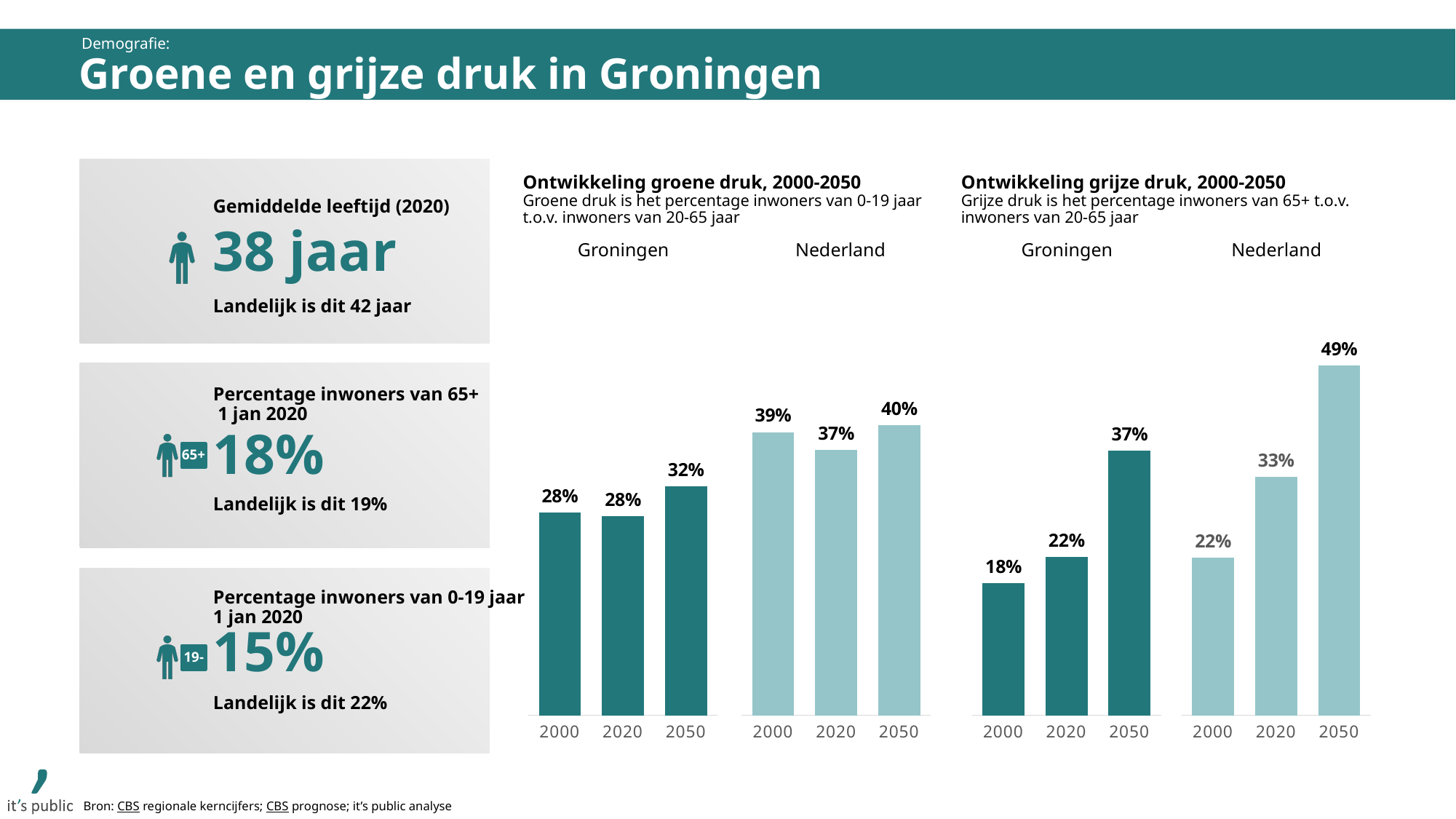
In the chart 'Ontwikkeling grijze druk, 2000-2050', what is the value for Nederland in 2050? 49% In the chart 'Ontwikkeling grijze druk, 2000-2050', which is larger: Groningen 2020 or Nederland 2020? Nederland 2020 In the chart 'Ontwikkeling grijze druk, 2000-2050', which bar has the highest value? Nederland 2050 In the chart 'Ontwikkeling grijze druk, 2000-2050', what is the difference between Nederland 2050 and Groningen 2050? 12% In the chart 'Ontwikkeling grijze druk, 2000-2050', what is the value for Groningen in 2000? 18% How many bars are shown in the chart 'Ontwikkeling groene druk, 2000-2050'? 6 In the chart 'Ontwikkeling groene druk, 2000-2050', which bar has the lowest value? Groningen 2000 and 2020 (28%) In the chart 'Ontwikkeling groene druk, 2000-2050', what is the value for Groningen in 2050? 32% In the chart 'Ontwikkeling groene druk, 2000-2050', what is the value for Nederland in 2000? 39% What kind of chart is 'Ontwikkeling grijze druk, 2000-2050'? bar chart In the chart 'Ontwikkeling grijze druk, 2000-2050', do the values for Groningen rise or fall from 2000 to 2050? rise In the chart 'Ontwikkeling groene druk, 2000-2050', what is the difference between Nederland 2000 and Groningen 2000? 11%